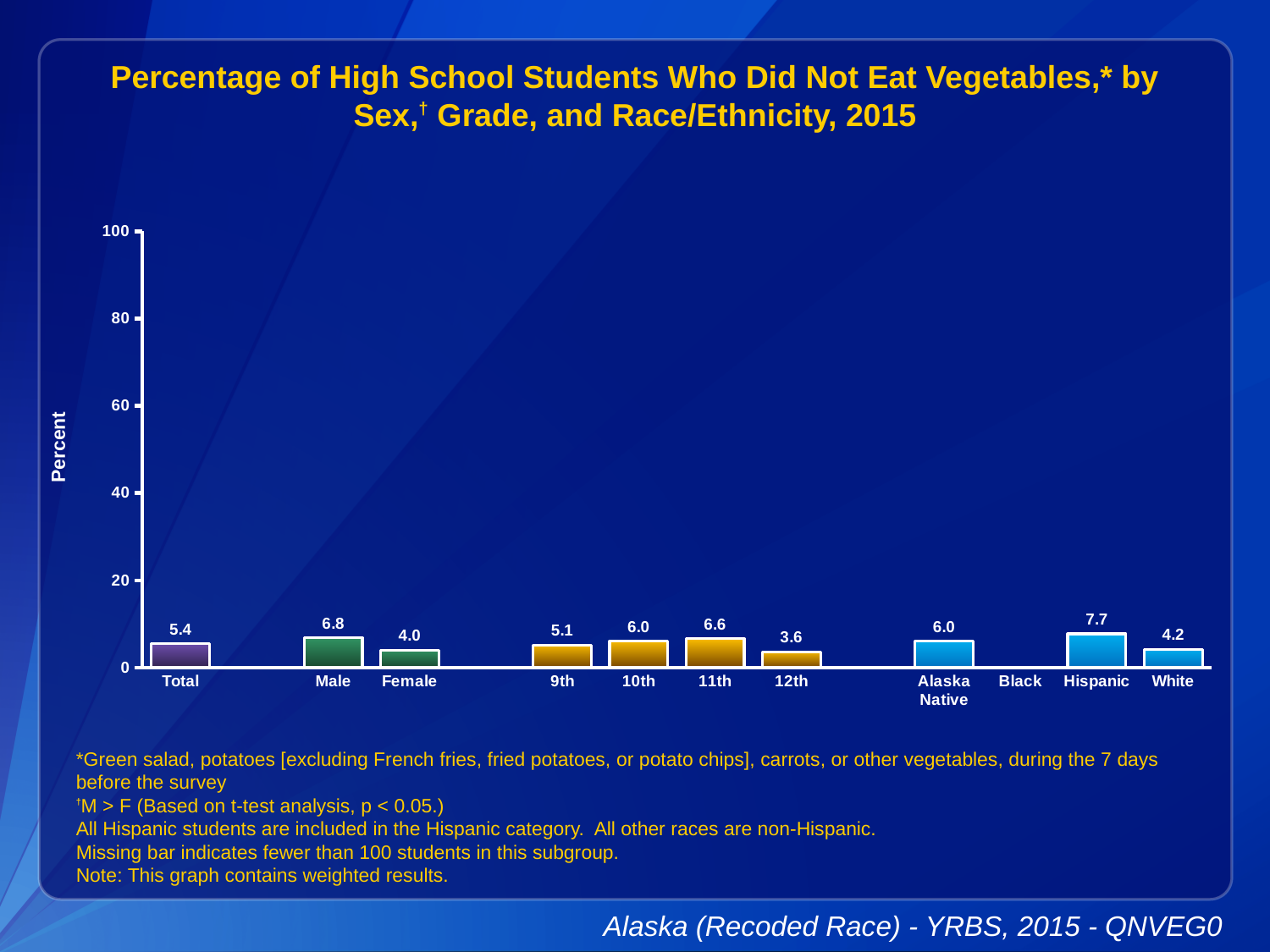
Which category has the lowest value among those with a bar? 12th What is the difference between the Male and Female values? 2.8 Which category on the x axis has no bar shown? Black Which category has the highest value? Hispanic What is the value for 12th grade? 3.6 How many categories on the x axis have a bar plotted? 11 What kind of chart is shown on the slide? bar chart Which is larger, the value for 11th grade or the value for 9th grade? 11th What is the value for Hispanic? 7.7 What is the value for Total? 5.4 Is the value for Alaska Native greater or less than 20? less What is the value for Male? 6.8